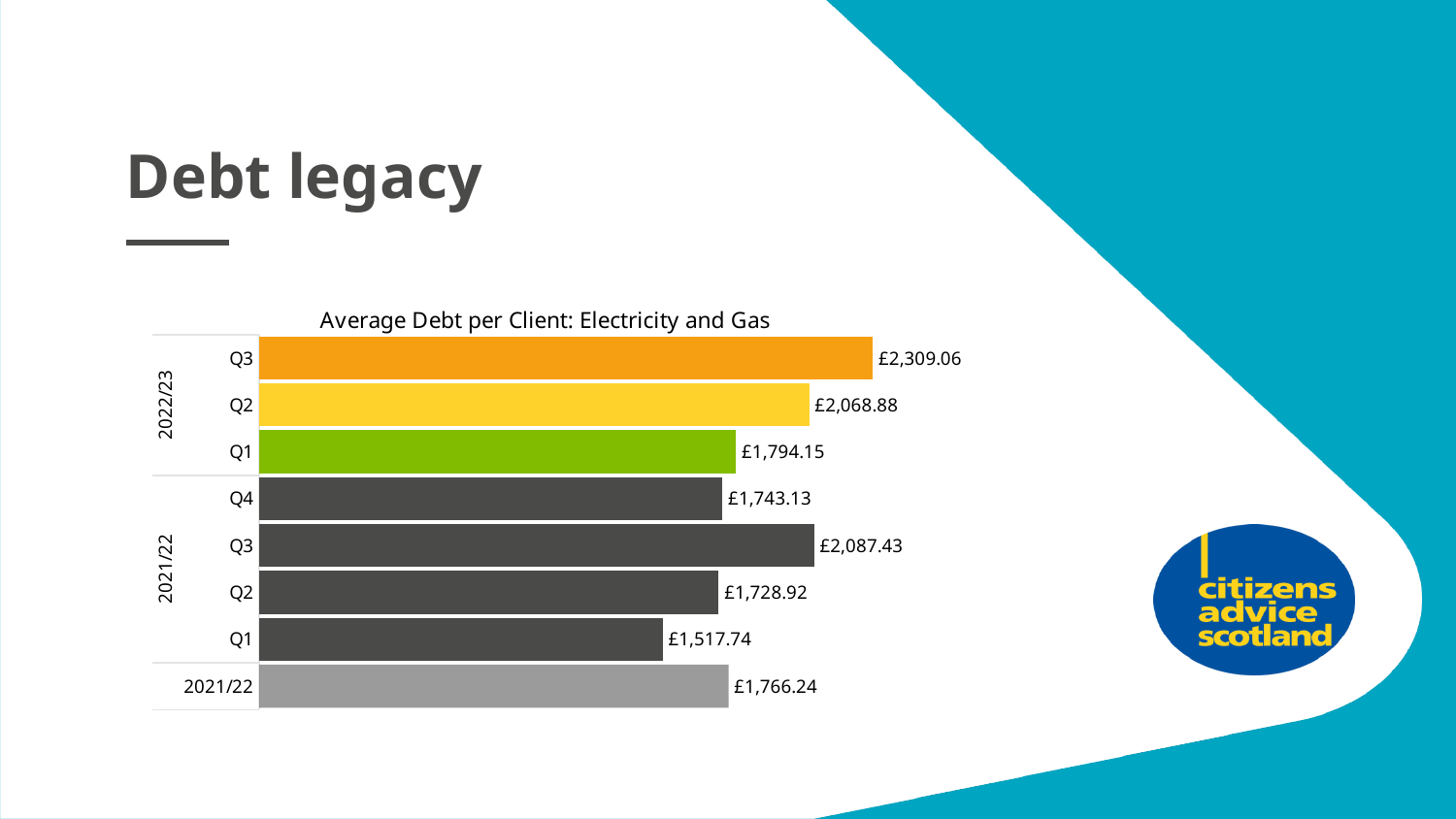
What is the difference between the average debt for Q3 2022/23 and Q2 2022/23? £240.18 What is the title of the chart? Average Debt per Client: Electricity and Gas What is the difference between the average debt for Q1 2022/23 and Q1 2021/22? £276.41 Which bar shows the highest average debt per client? Q3 2022/23 Which is larger, the average debt for Q3 2021/22 or Q2 2022/23? Q3 2021/22 What is the average debt per client for Q4 of 2021/22? £1,743.13 What type of chart is shown on the slide? Bar chart What is the average debt per client for the full year 2021/22? £1,766.24 What is the average debt per client for Q3 of 2022/23? £2,309.06 What is the average debt per client for Q1 of 2021/22? £1,517.74 Which bar shows the lowest average debt per client? Q1 2021/22 How many bars are plotted in the chart? 8